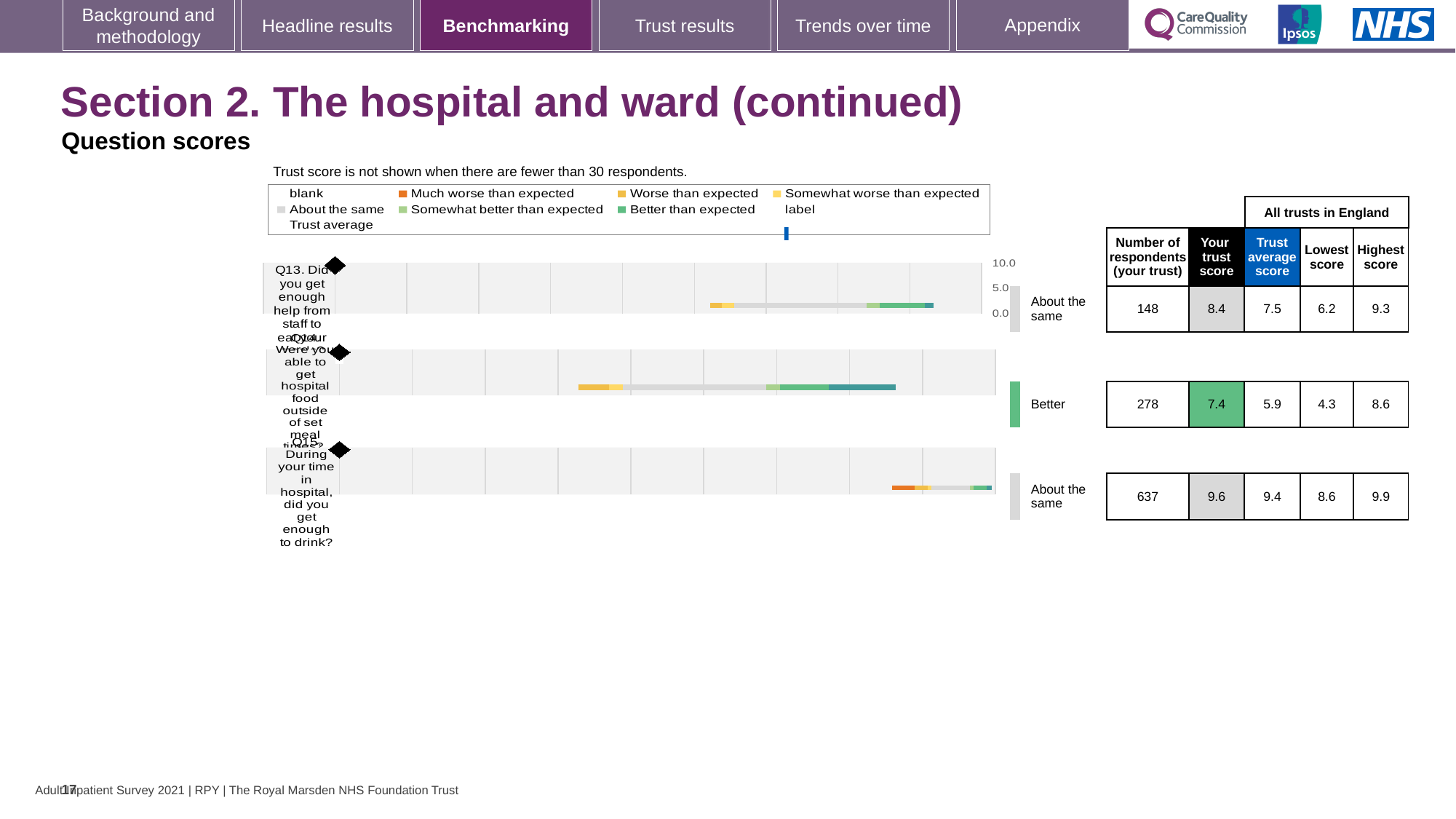
How many respondents from the trust answered Q15? 637 What is the trust score for Q14 (Were you able to get hospital food outside of set meal times?)? 7.4 What is the trust score for Q15 (During your time in hospital, did you get enough to drink?)? 9.6 Which question has the highest trust score? Q15 Which question has the fewest respondents from the trust? Q13 What is the difference between the trust score and the trust average score for Q14? 1.5 What is the highest score among all trusts in England for Q13? 9.3 Which question is rated 'Better' rather than 'About the same' in the benchmarking chart? Q14 What is the trust score for Q13 (Did you get enough help from staff to eat your meals?)? 8.4 How many questions are plotted in the chart on this slide? 3 What is the trust average score across all trusts in England for Q14? 5.9 What kind of chart is used to show the question scores on this slide? bar chart